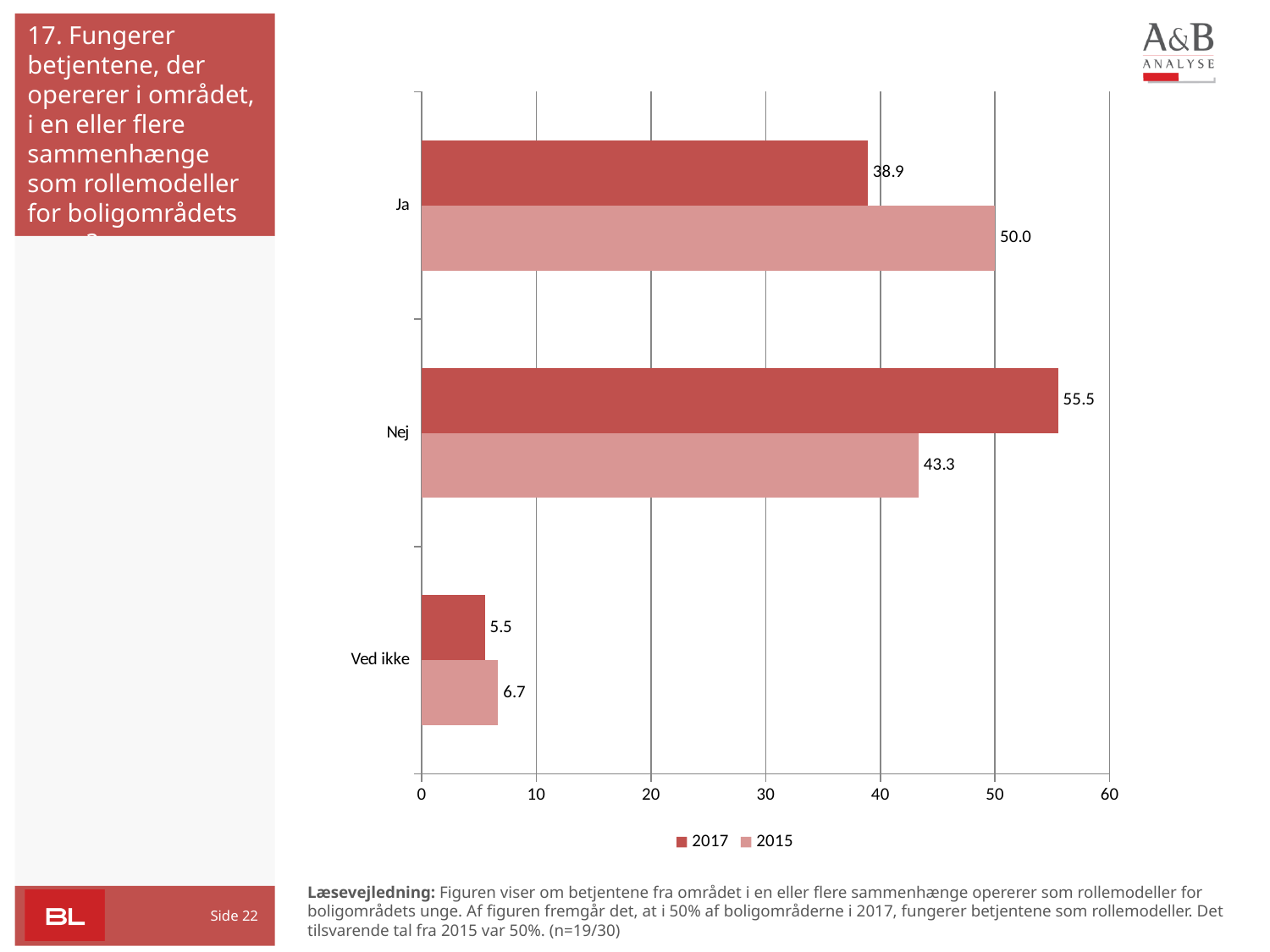
What is the value for "Ja" in the 2015 series? 50.0 What is the value for "Ved ikke" in the 2015 series? 6.7 Is the 2017 value for "Nej" greater or less than 50? greater Which category has the lowest value in the 2015 series? Ved ikke What is the value for "Ja" in the 2017 series? 38.9 Which category has the highest value in the 2017 series? Nej What kind of chart is shown on the slide? Bar chart What is the difference between the 2017 and 2015 values for "Nej"? 12.2 For "Ja", which series has the larger value, 2017 or 2015? 2015 What is the value for "Nej" in the 2017 series? 55.5 How many series does the legend list? 2 How many categories are shown on the chart? 3